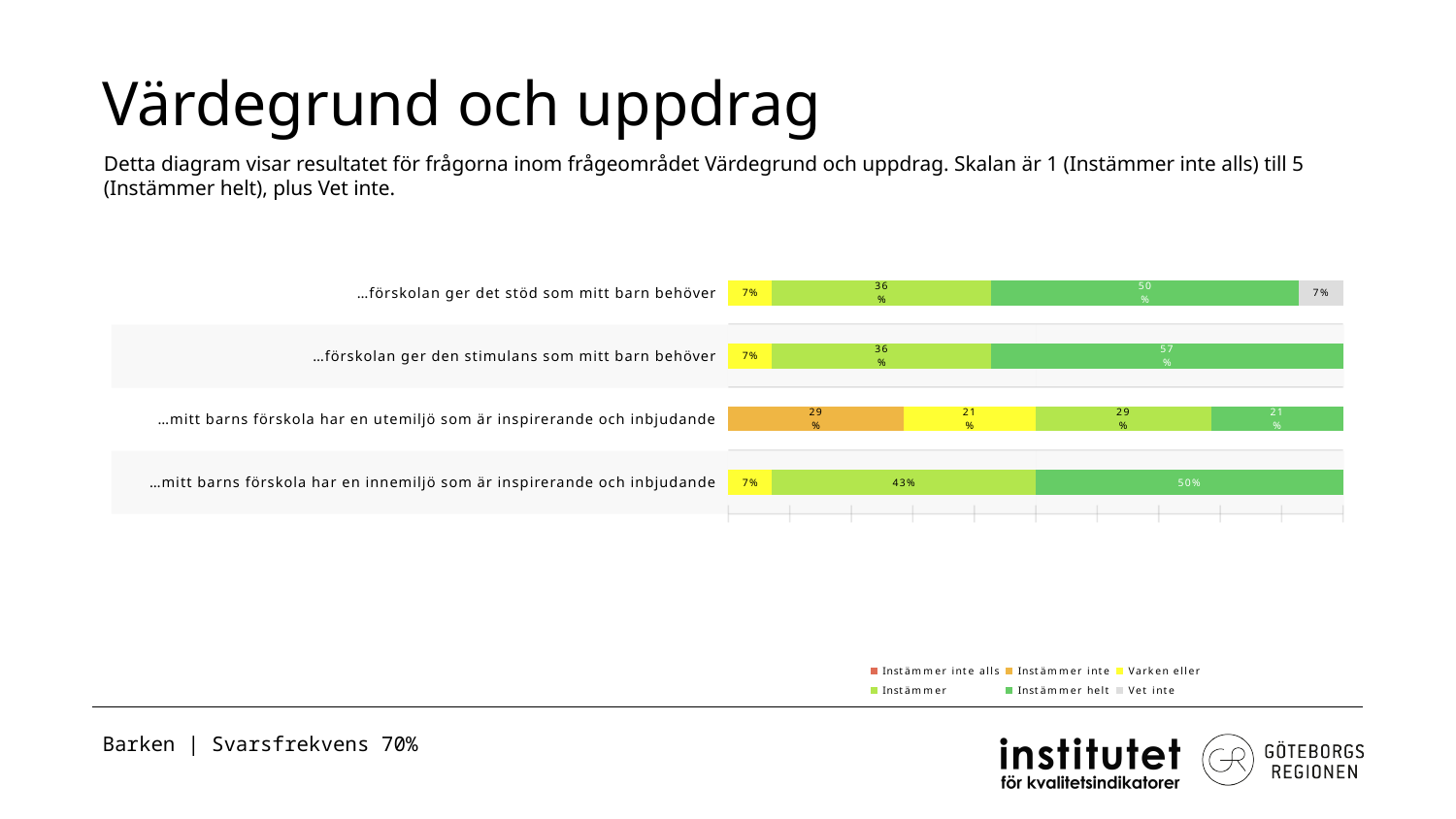
How many statements (categories) are plotted in the chart? 4 What is the 'Instämmer' value for '…mitt barns förskola har en innemiljö som är inspirerande och inbjudande'? 43% What is the 'Vet inte' value for '…förskolan ger det stöd som mitt barn behöver'? 7% Which statement has the highest 'Instämmer helt' value? …förskolan ger den stimulans som mitt barn behöver What is the difference between the 'Instämmer helt' values for '…förskolan ger den stimulans som mitt barn behöver' and '…förskolan ger det stöd som mitt barn behöver'? 7% What is the 'Instämmer helt' value for '…förskolan ger det stöd som mitt barn behöver'? 50% Which statement has the lowest 'Instämmer helt' value? …mitt barns förskola har en utemiljö som är inspirerande och inbjudande What is the 'Instämmer inte' value for '…mitt barns förskola har en utemiljö som är inspirerande och inbjudande'? 29% What kind of chart is shown on the slide? Stacked bar chart What is the 'Instämmer helt' value for '…förskolan ger den stimulans som mitt barn behöver'? 57% Which is larger: the 'Instämmer' value for '…mitt barns förskola har en innemiljö som är inspirerande och inbjudande' or for '…förskolan ger det stöd som mitt barn behöver'? …mitt barns förskola har en innemiljö som är inspirerande och inbjudande How many series does the legend list? 6